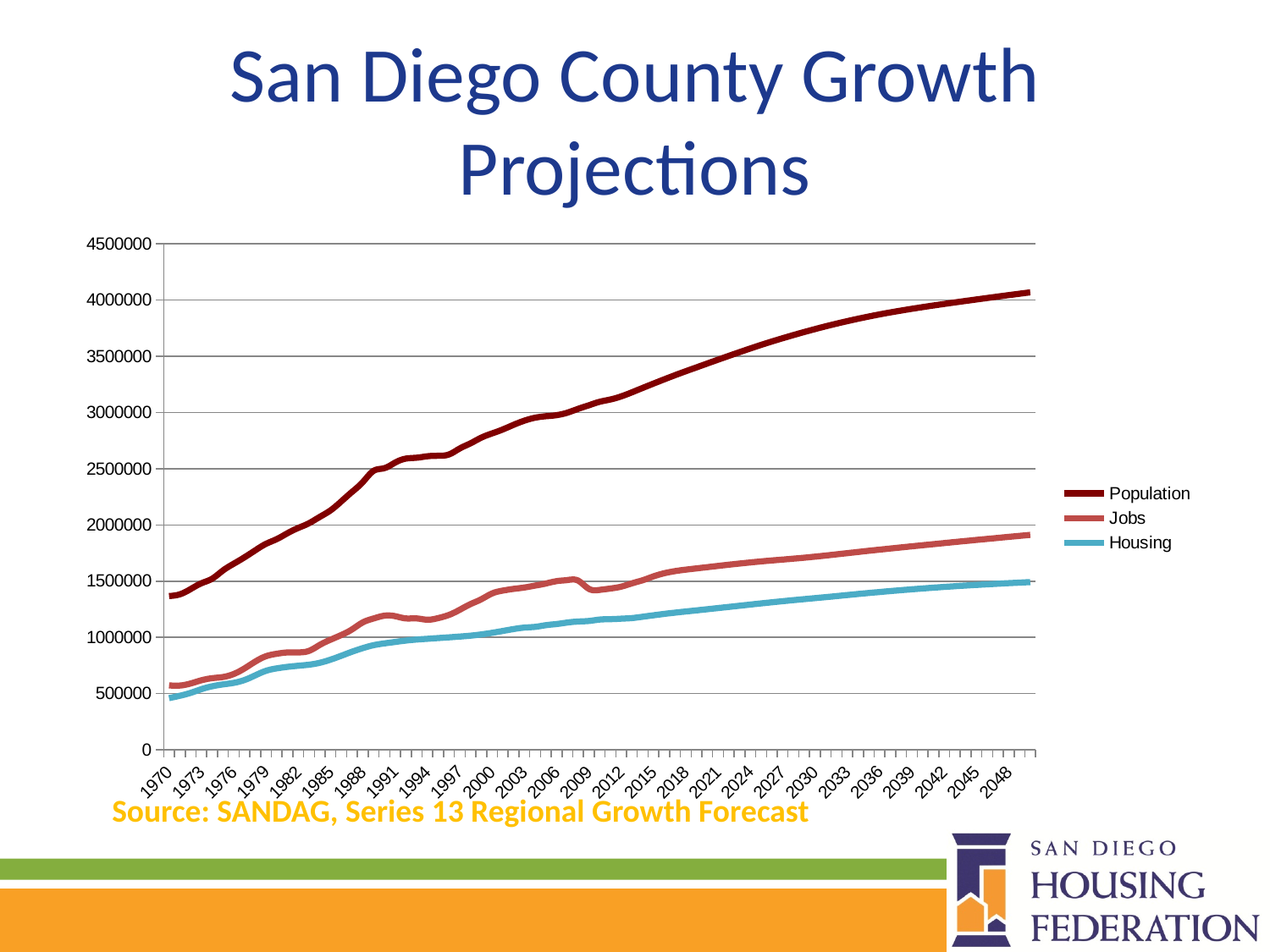
How many series does the legend list? 3 Is the Jobs value for 2048 greater or less than 2000000? less What colour is the Housing line in the legend? Light blue Which series has the lowest values across the whole chart? Housing Does the Population line rise or fall from 1970 to 2048? Rises In 2048, which is larger, Jobs or Housing? Jobs Is the Population value for 2030 greater or less than 3500000? greater Is the Housing value for 2030 greater or less than 1000000? greater What is the title of the chart on the slide? San Diego County Growth Projections What kind of chart is shown on the slide? Line chart Which series has the highest values across the whole chart? Population